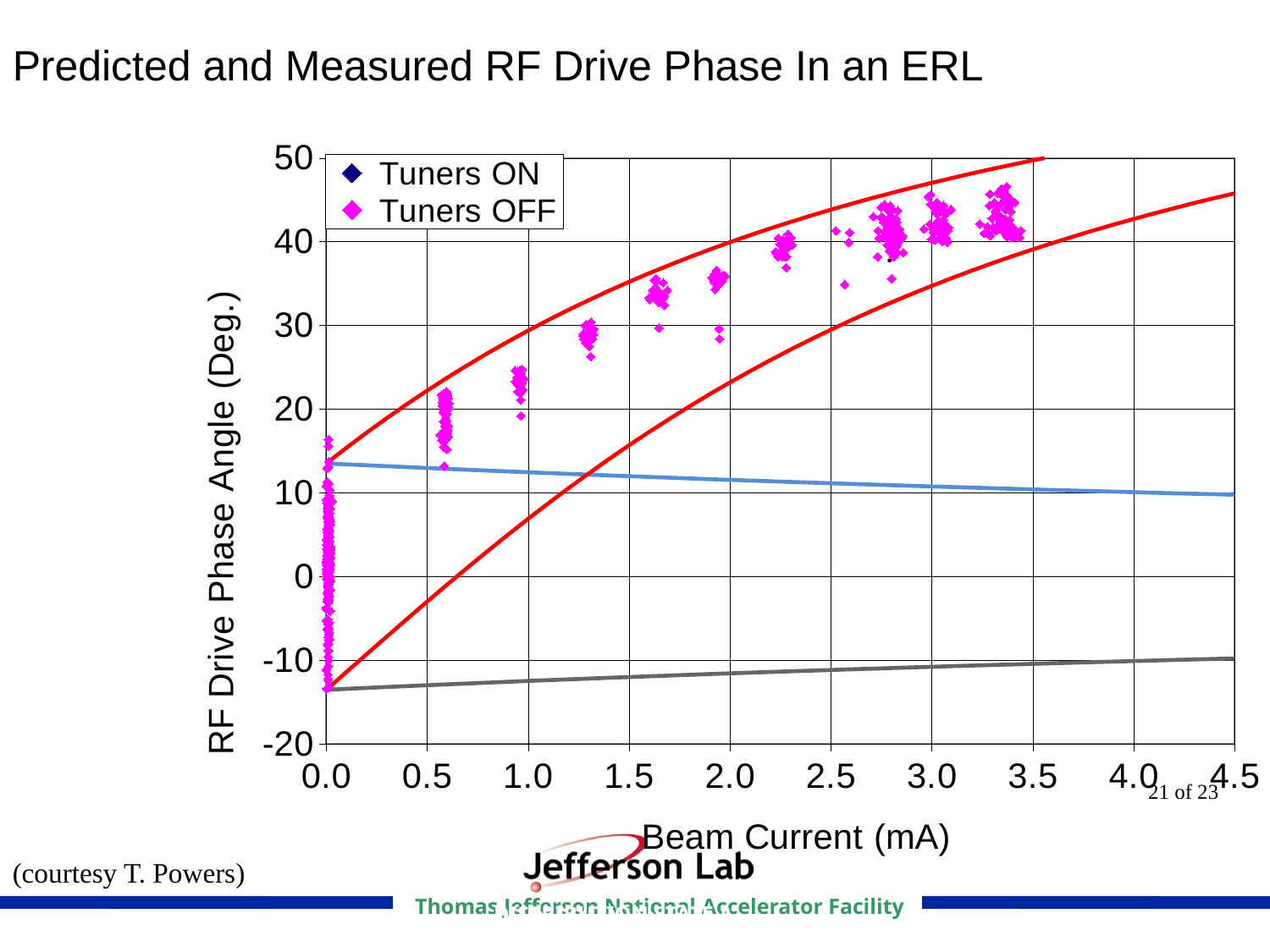
What kind of chart is shown on the slide? Scatter chart Do the Tuners OFF data points rise or fall as beam current increases along the x axis? Rise How many series does the chart legend list? 2 Does the blue line rise or fall as beam current increases? Fall Are the Tuners OFF values near 3.0 mA beam current greater or less than 30 degrees? greater Are the Tuners OFF values near 0.5 mA beam current greater or less than 30 degrees? less What is the highest value shown on the y axis of the chart? 50 Does the grey line rise or fall as beam current increases? Rise Which has the larger RF drive phase angle: the Tuners OFF points near 3.5 mA or the Tuners OFF points near 1.0 mA? Tuners OFF points near 3.5 mA Are the Tuners OFF values near 2.0 mA beam current greater or less than 20 degrees? greater What is the title of the chart's x axis? Beam Current (mA) What are the two series named in the chart legend? Tuners ON and Tuners OFF